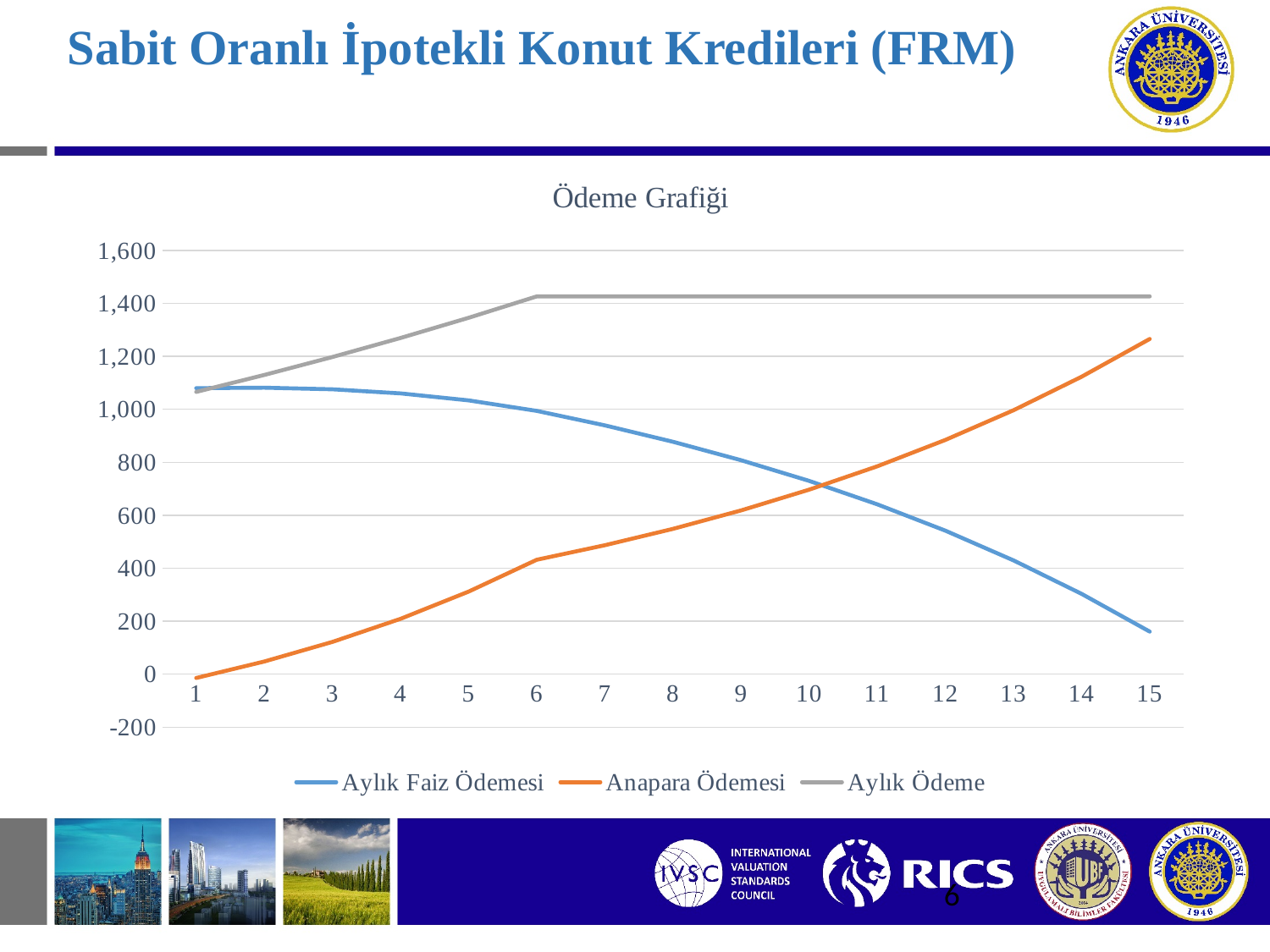
Which series is drawn in orange? Anapara Ödemesi Does the Anapara Ödemesi series rise or fall from 1 to 15? rise Does the Aylık Faiz Ödemesi series rise or fall from 1 to 15? fall What kind of chart is shown on the slide? line chart Which series has the highest value at 10? Aylık Ödeme How many points are plotted along the x axis for each series? 15 At 15, which is larger: Anapara Ödemesi or Aylık Faiz Ödemesi? Anapara Ödemesi Is the value of Aylık Faiz Ödemesi at 15 greater or less than 200? less What is the title of the chart? Ödeme Grafiği How many series does the legend list? 3 Is the value of Aylık Ödeme at 10 greater or less than 1,400? greater Is the value of Anapara Ödemesi at 15 greater or less than 1,200? greater